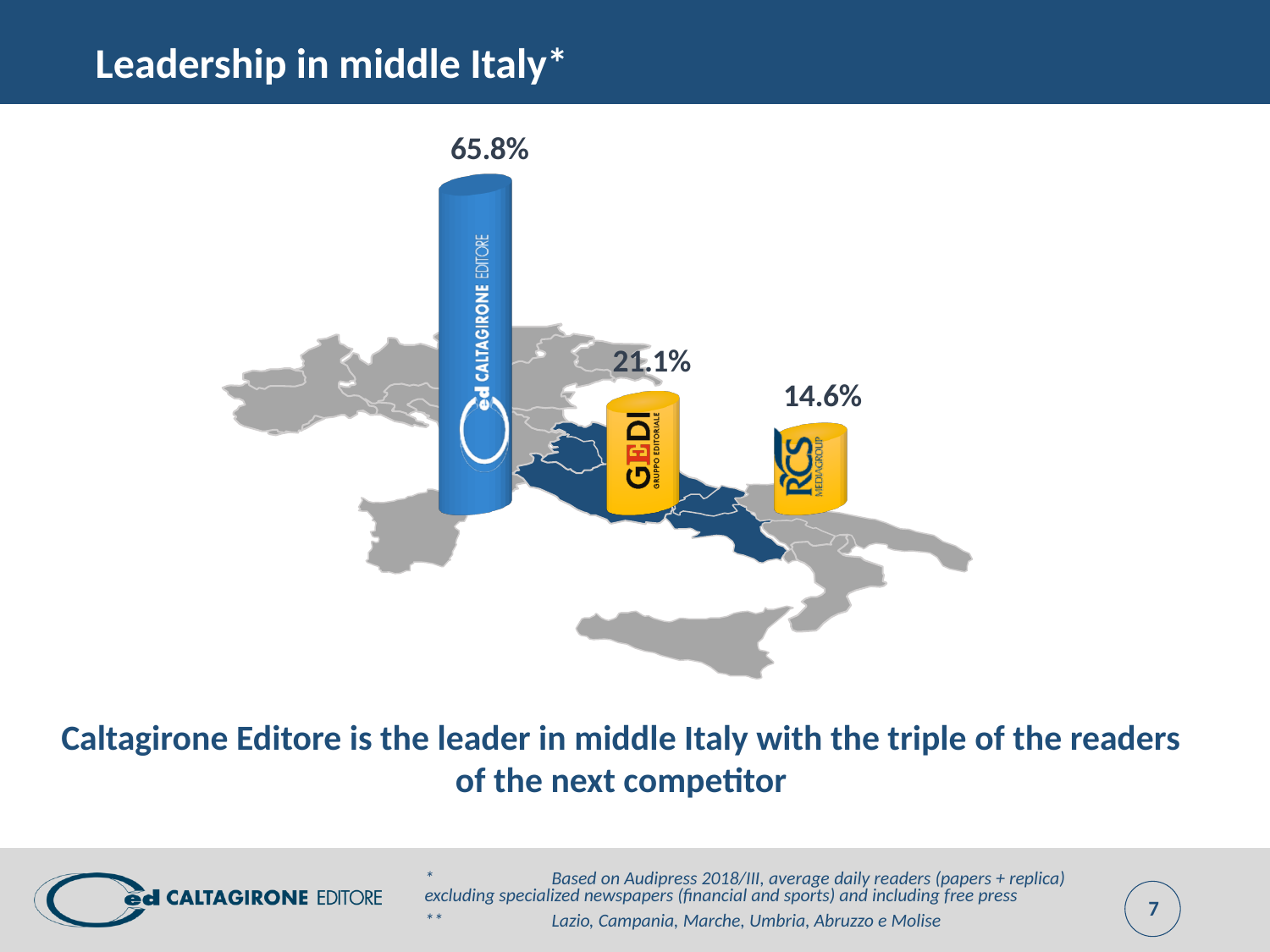
What is the value shown for Caltagirone Editore? 65.8% Which publisher has the highest value on the chart? Caltagirone Editore Which is larger, the value for GEDI or the value for RCS? GEDI What is the value shown for RCS? 14.6% What is the title of the slide containing the chart? Leadership in middle Italy* How many publishers are shown on the chart? 3 Which publisher has the lowest value on the chart? RCS What is the difference between the values for GEDI and RCS? 6.5% What kind of chart is shown on the slide? Bar chart What is the difference between the values for Caltagirone Editore and GEDI? 44.7% What colour is the bar for Caltagirone Editore? Blue What is the value shown for GEDI? 21.1%